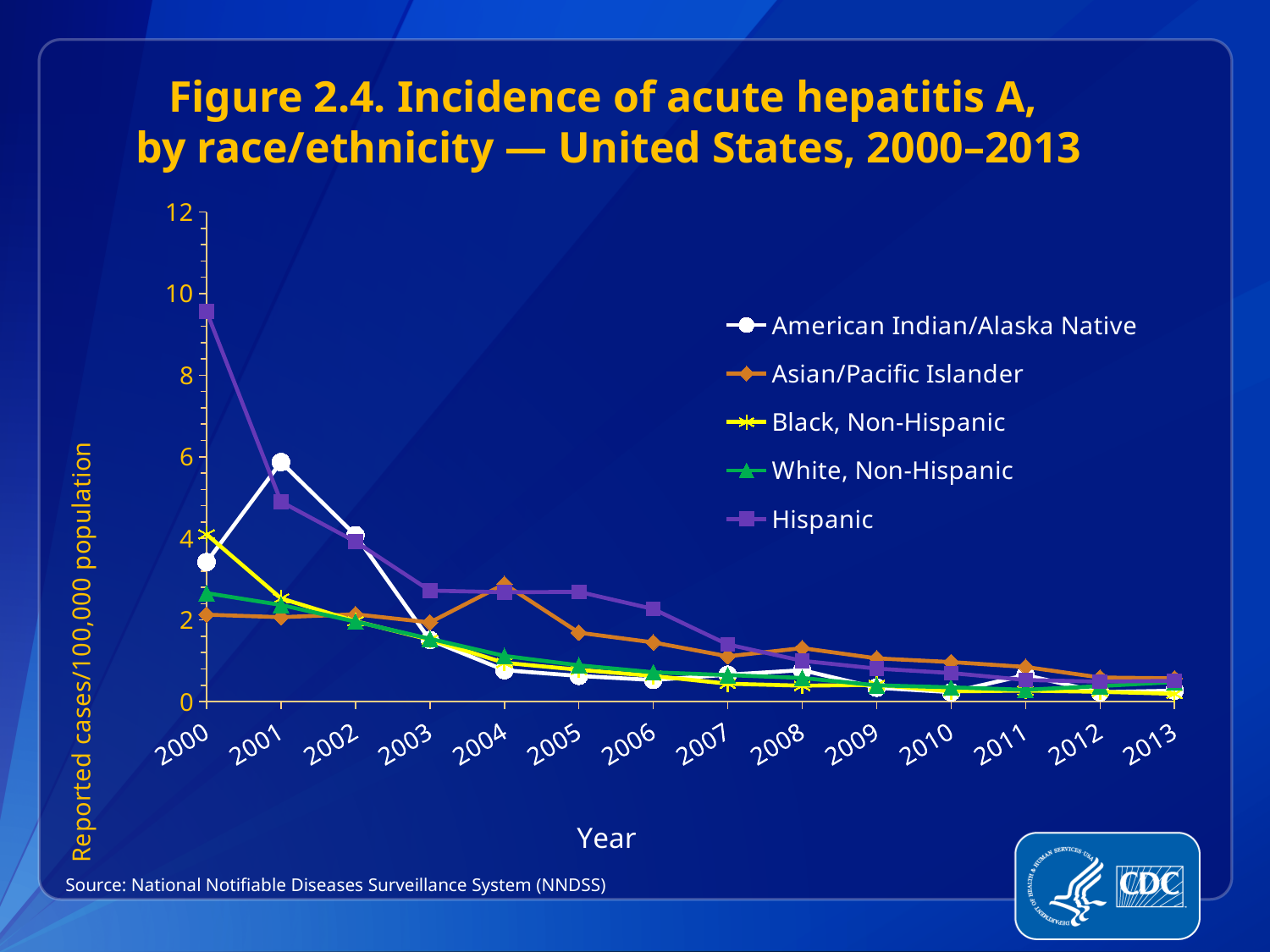
In 2001, which is larger: the value for American Indian/Alaska Native or the value for Hispanic? American Indian/Alaska Native Is the value for Asian/Pacific Islander in 2005 greater or less than 2? less Which race/ethnicity group had the highest incidence in 2001? American Indian/Alaska Native How many series does the legend list? 5 What is the label of the y axis? Reported cases/100,000 population Does the Hispanic series rise or fall from 2000 to 2013? fall How many years are plotted along the x axis? 14 What kind of chart is shown on the slide? line chart Is the value for American Indian/Alaska Native in 2001 greater or less than 4? greater What is the source cited at the bottom of the slide? National Notifiable Diseases Surveillance System (NNDSS) Which race/ethnicity group had the highest incidence in 2000? Hispanic Is the value for Hispanic in 2000 greater or less than 8? greater